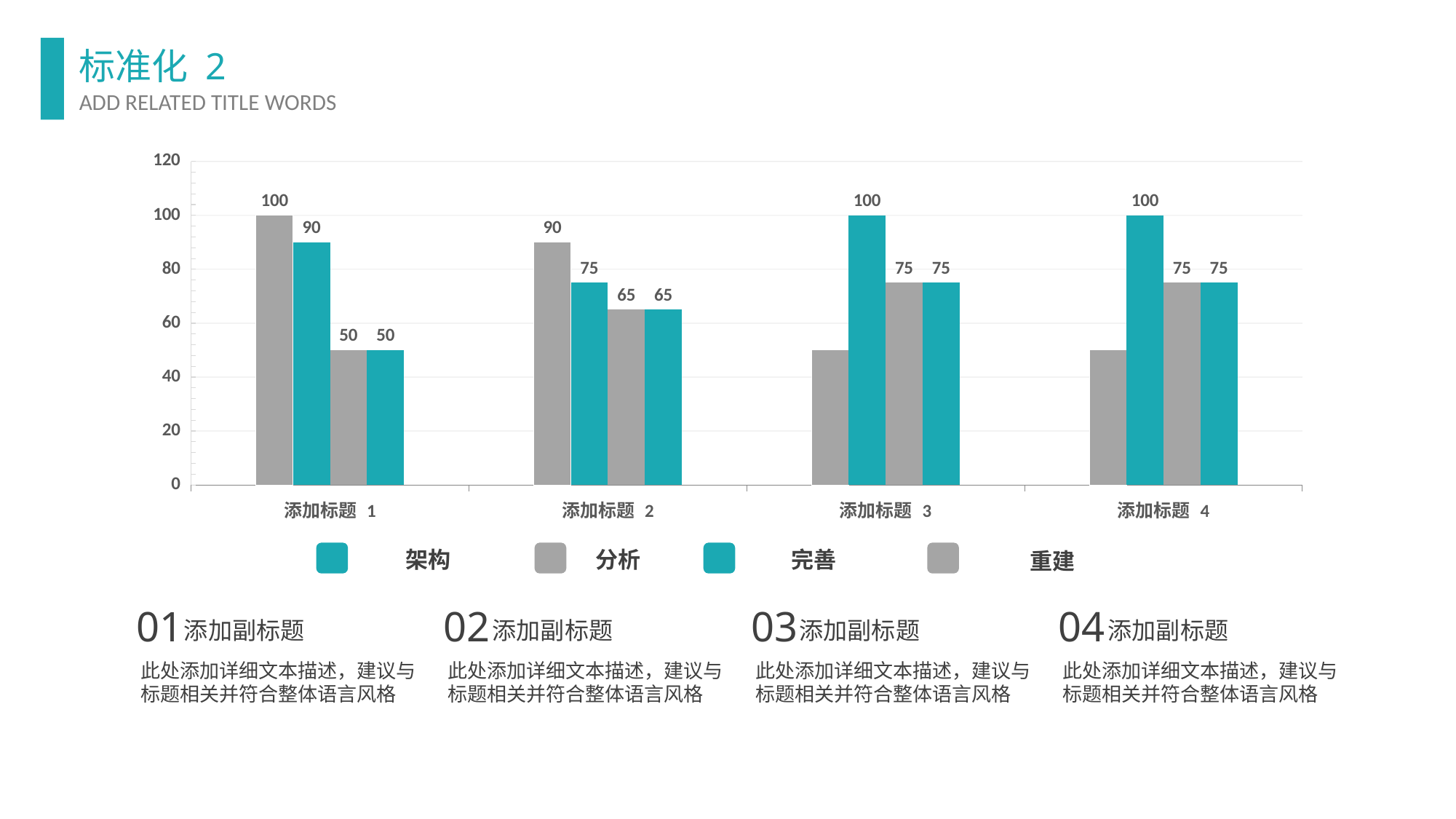
What is the difference between the first bar (90) and the third bar (65) in the 添加标题 2 group? 25 What is the value of the third bar in the 添加标题 4 group? 75 What are the four entries listed in the chart's legend? 架构, 分析, 完善, 重建 What is the difference between the first and second bars in the 添加标题 1 group? 10 What kind of chart is shown on the slide? bar chart Which bar has the highest value in the 添加标题 2 group? the first (leftmost) bar, 90 What is the value of the first (leftmost) bar in the 添加标题 1 group? 100 Which group has the larger second bar, 添加标题 1 or 添加标题 2? 添加标题 1 How many categories are shown on the x axis of the chart? 4 Is the value of the first (leftmost) bar in the 添加标题 3 group greater or less than 60? less What is the value of the second bar in the 添加标题 2 group? 75 How many series does the chart's legend list? 4